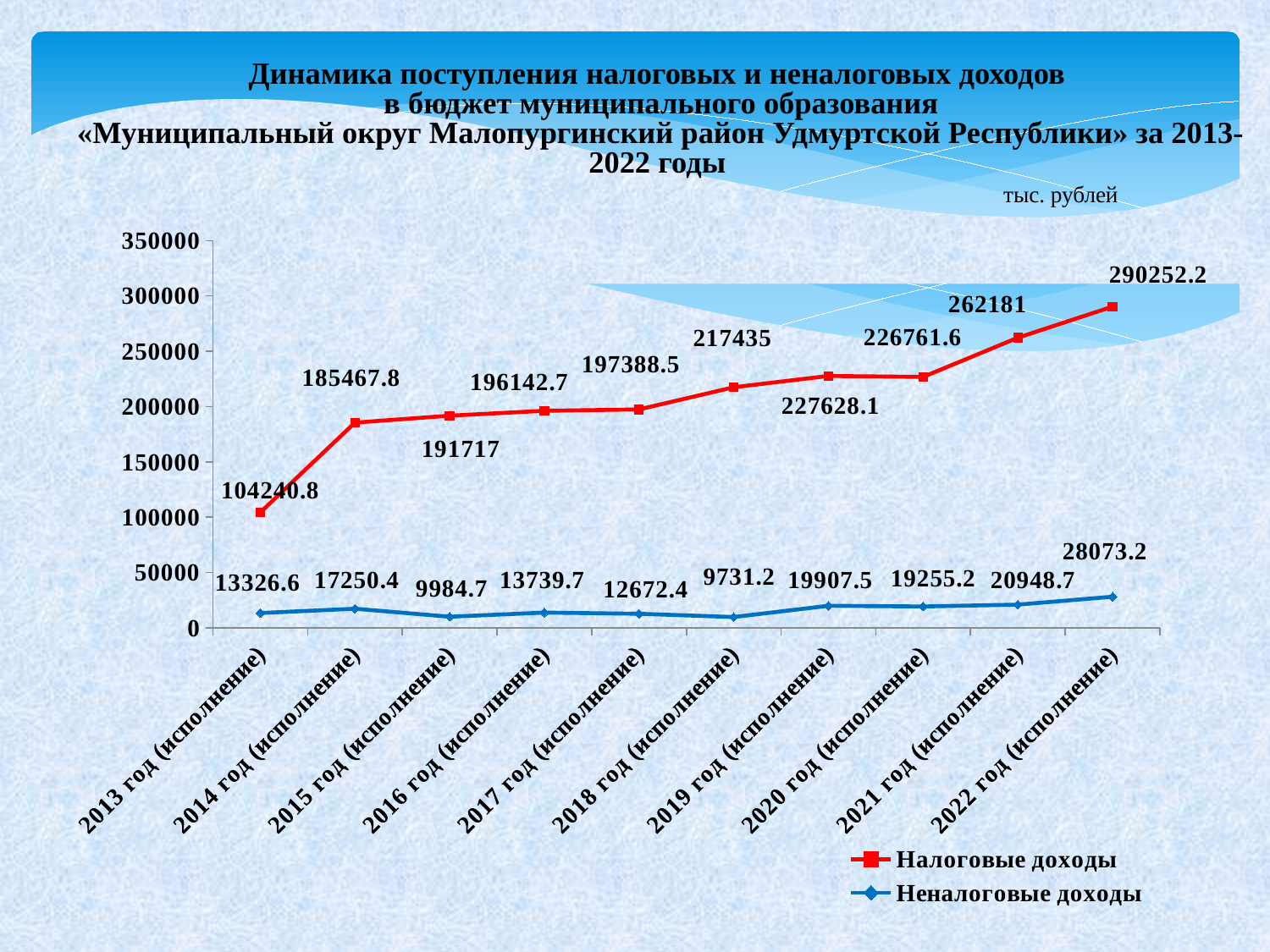
In which year is Неналоговые доходы highest? 2022 год (исполнение) How many series does the legend list? 2 What is the value of Налоговые доходы for 2022 год (исполнение)? 290252.2 What is the difference between Неналоговые доходы in 2022 and in 2021? 7124.5 In which year is Налоговые доходы lowest? 2013 год (исполнение) Which year has the larger value of Налоговые доходы, 2019 or 2020? 2019 год (исполнение) How many years are shown on the x axis? 10 What is the difference between Налоговые доходы in 2022 and in 2021? 28071.2 What kind of chart is shown on the slide? Line chart What is the value of Налоговые доходы for 2013 год (исполнение)? 104240.8 What is the value of Неналоговые доходы for 2018 год (исполнение)? 9731.2 In which year is Неналоговые доходы lowest? 2018 год (исполнение)